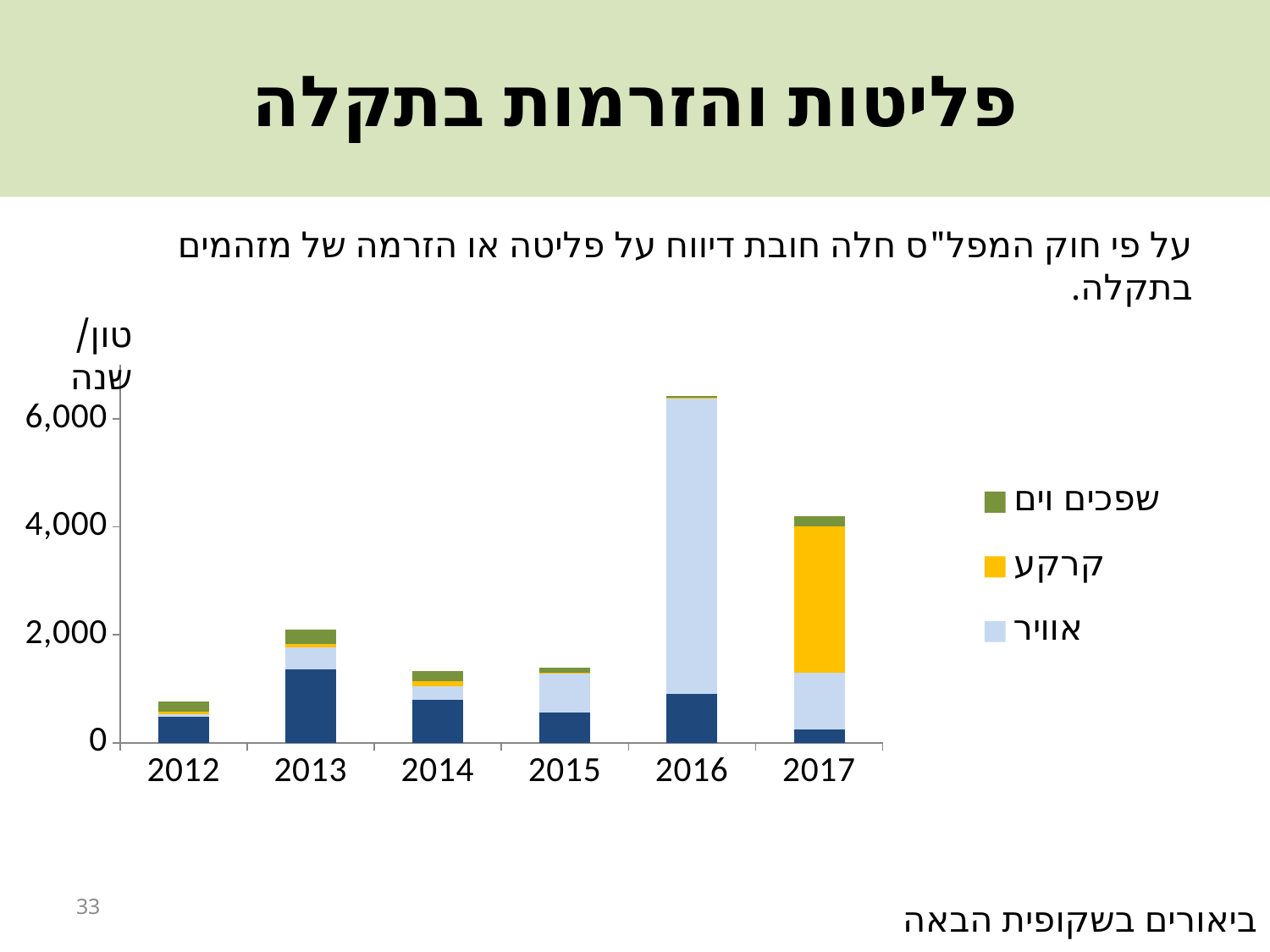
Is the total for 2016 greater or less than 6,000? greater Is the total for 2017 greater or less than 2,000? greater Is the total for 2012 greater or less than 2,000? less Which year has the larger total, 2016 or 2017? 2016 Which year has the shortest stacked bar? 2012 Which year has the tallest stacked bar? 2016 How many series does the chart's legend list? 3 In which year is the קרקע (yellow) segment largest? 2017 What kind of chart is shown on the slide? Stacked bar chart How many years are shown on the x axis of the chart? 6 Which year has the larger total, 2013 or 2014? 2013